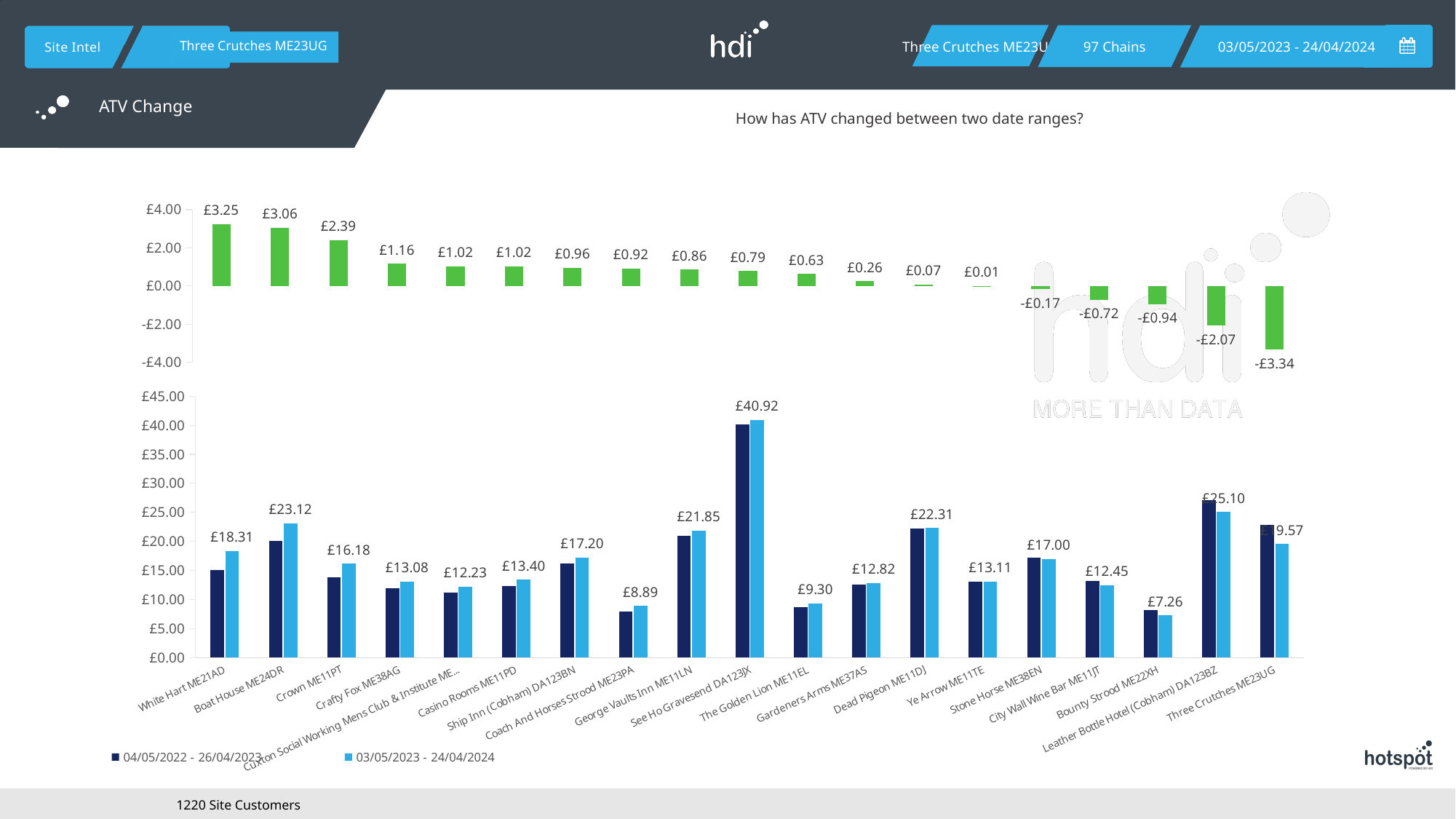
In the lower chart, what is the difference between the 03/05/2023 - 24/04/2024 values for Boat House ME24DR and White Hart ME21AD? £4.81 In the lower chart, which is larger in the 03/05/2023 - 24/04/2024 series: Dead Pigeon ME11DJ or George Vaults Inn ME11LN? Dead Pigeon ME11DJ How many series does the legend of the lower chart list? 2 What kind of chart is the lower chart on the slide? bar chart In the lower chart, which category has the highest value in the 03/05/2023 - 24/04/2024 series? See Ho Gravesend DA123JX In the upper chart, what is the lowest value shown? -£3.34 In the lower chart, is the 04/05/2022 - 26/04/2023 value for See Ho Gravesend DA123JX greater or less than £35.00? greater In the upper chart, what is the highest value shown? £3.25 In the lower chart, what is the value for See Ho Gravesend DA123JX in the 03/05/2023 - 24/04/2024 series? £40.92 In the lower chart, which category has the lowest value in the 03/05/2023 - 24/04/2024 series? Bounty Strood ME22XH How many categories are shown on the x axis of the lower chart? 19 In the lower chart, what is the value for Bounty Strood ME22XH in the 03/05/2023 - 24/04/2024 series? £7.26